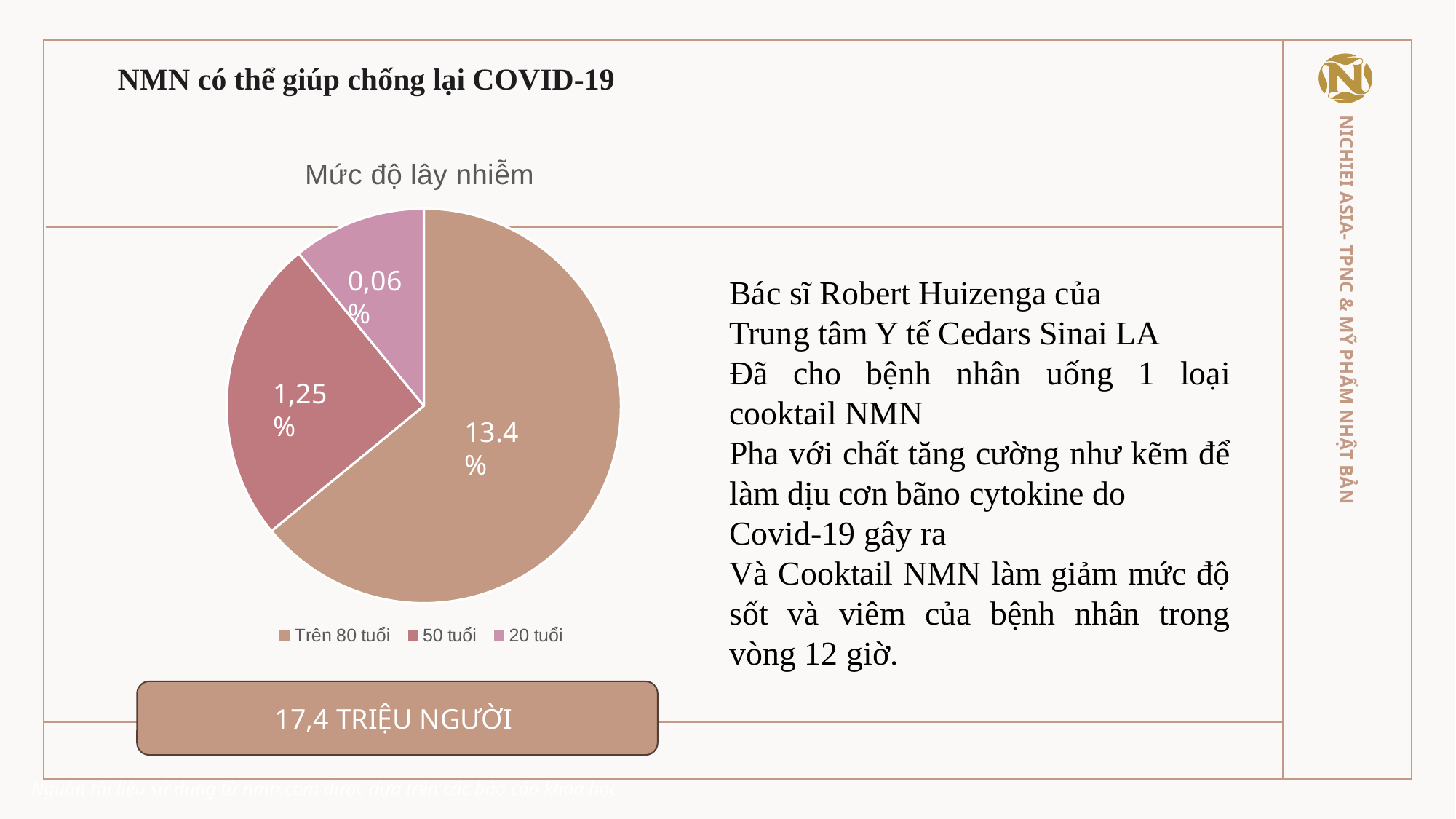
What is the value shown for the '20 tuổi' slice of the pie chart? 0,06% Which legend entry is shown in the lightest pink colour in the pie chart? 20 tuổi Which category has the smallest slice in the pie chart? 20 tuổi How many slices does the pie chart have? 3 How many entries does the legend of the pie chart list? 3 What is the difference between the '50 tuổi' and '20 tuổi' values in the pie chart? 1,19% What is the value shown for the 'Trên 80 tuổi' slice of the pie chart? 13.4% What type of chart is shown on the slide? Pie chart Which category has the largest slice in the pie chart? Trên 80 tuổi What is the title of the pie chart? Mức độ lây nhiễm Which slice is larger in the pie chart: '50 tuổi' or '20 tuổi'? 50 tuổi What is the value shown for the '50 tuổi' slice of the pie chart? 1,25%